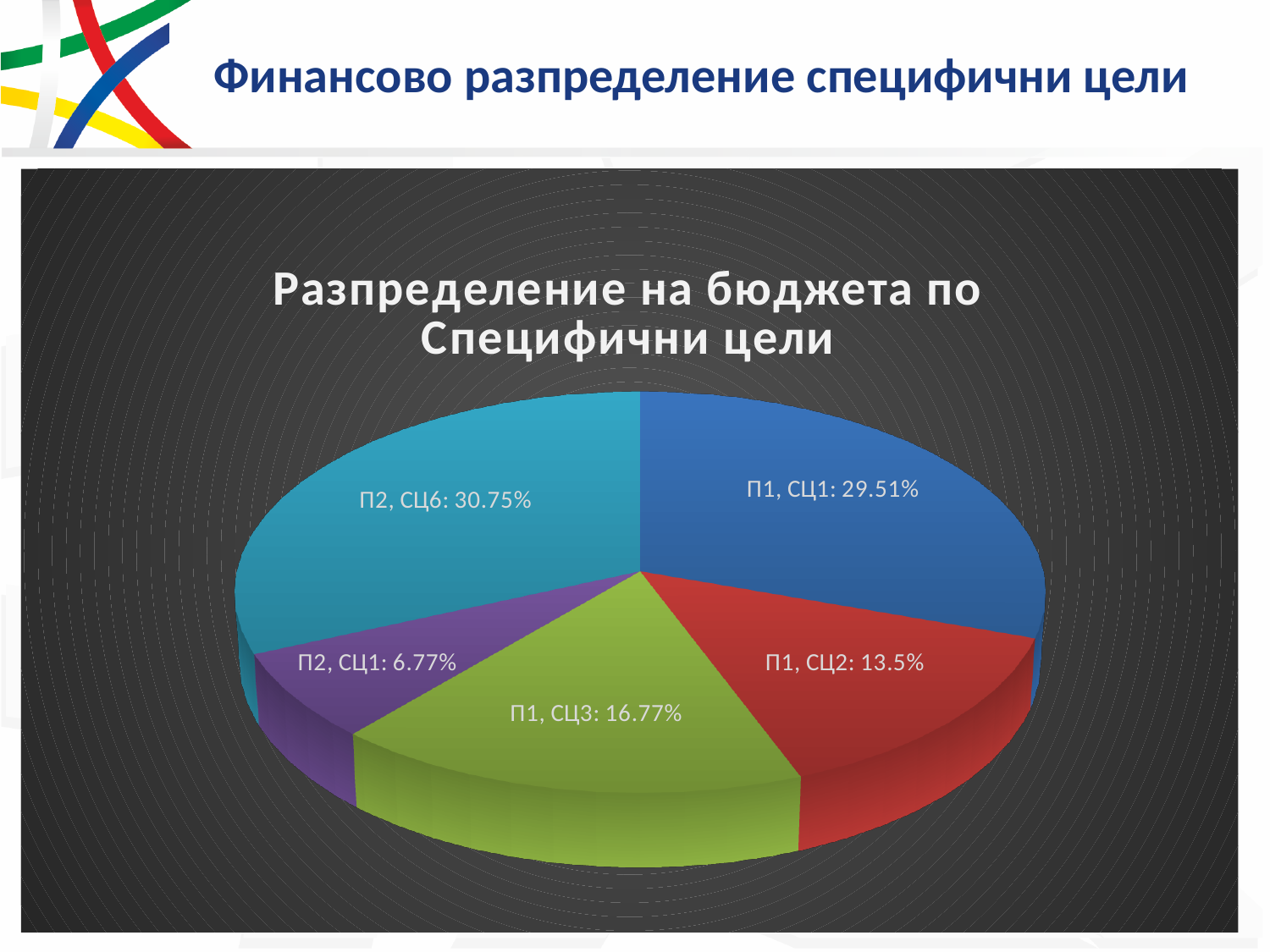
What type of chart is shown on the slide? Pie chart What share of the budget goes to П2, СЦ6? 30.75% What share of the budget goes to П1, СЦ3? 16.77% Which specific objective has the smallest share of the budget? П2, СЦ1 What is the chart's title? Разпределение на бюджета по Специфични цели Which has a larger share, П1, СЦ2 or П1, СЦ3? П1, СЦ3 Which specific objective has the largest share of the budget? П2, СЦ6 What share of the budget goes to П2, СЦ1? 6.77% What share of the budget goes to П1, СЦ1? 29.51% What colour is the slice for П1, СЦ2? Red What is the difference between the shares of П1, СЦ3 and П1, СЦ2? 3.27% How many slices does the pie chart have? 5